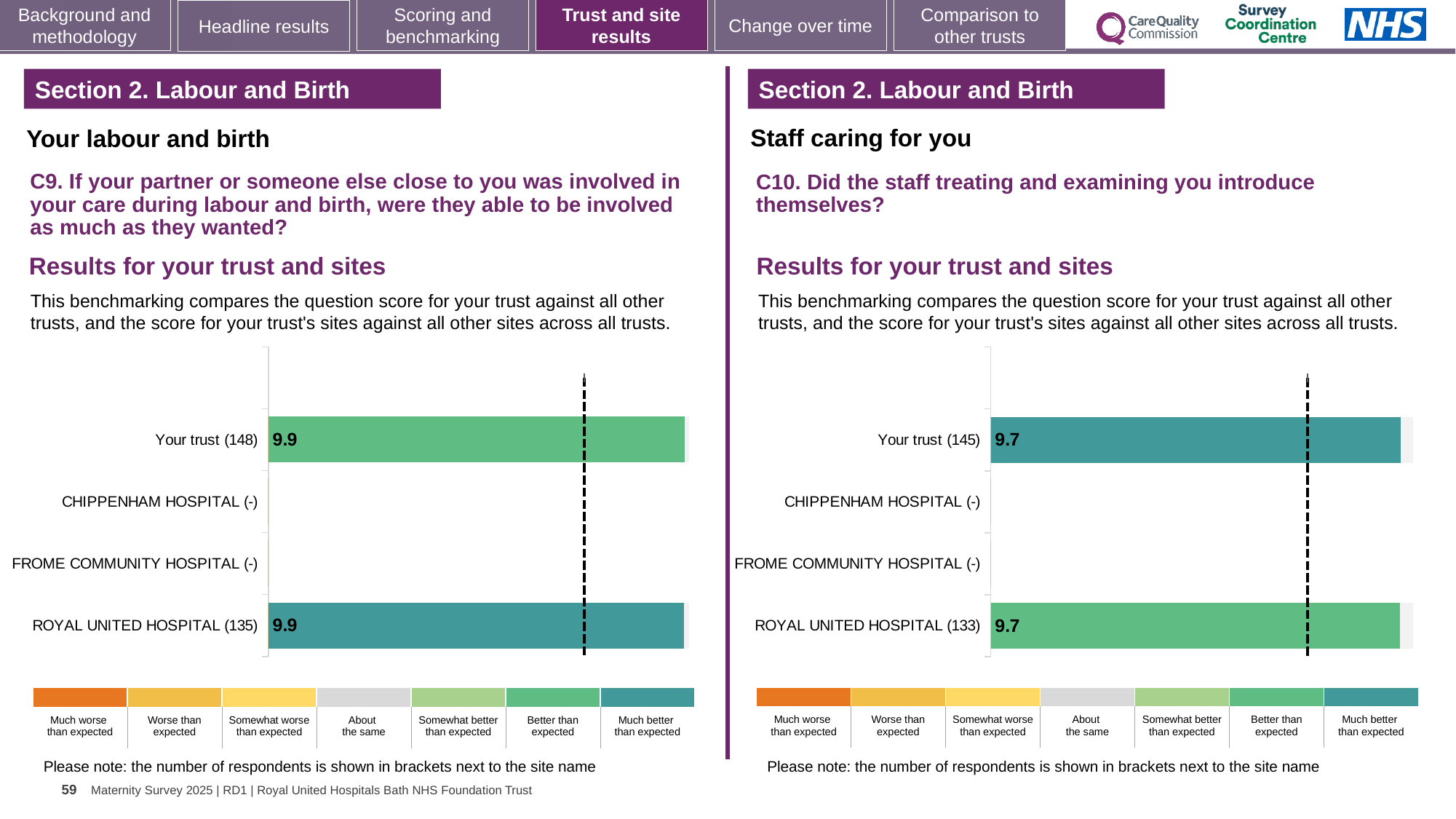
How many site or trust categories are listed on the y axis of the C9 chart on the left? 4 In the C9 chart on the left, how many respondents are shown in brackets for Your trust? 148 In the C10 chart on the right, which benchmark category does the colour of the Your trust bar correspond to in the legend? Much better than expected How many benchmark categories does the colour legend below the C9 chart on the left list? 7 In the C9 chart on the left, what is the score for Your trust? 9.9 What kind of chart is used for the C10 results on the right? bar chart In the C9 chart on the left, what is the score for ROYAL UNITED HOSPITAL? 9.9 In the C10 chart on the right, what is the score for Your trust? 9.7 Which is larger: the Your trust score in the C9 chart on the left or the Your trust score in the C10 chart on the right? C9 chart on the left In the C10 chart on the right, how many respondents are shown in brackets for ROYAL UNITED HOSPITAL? 133 What is the difference between the Your trust score in the C9 chart on the left and the Your trust score in the C10 chart on the right? 0.2 In the C10 chart on the right, what is the score for ROYAL UNITED HOSPITAL? 9.7